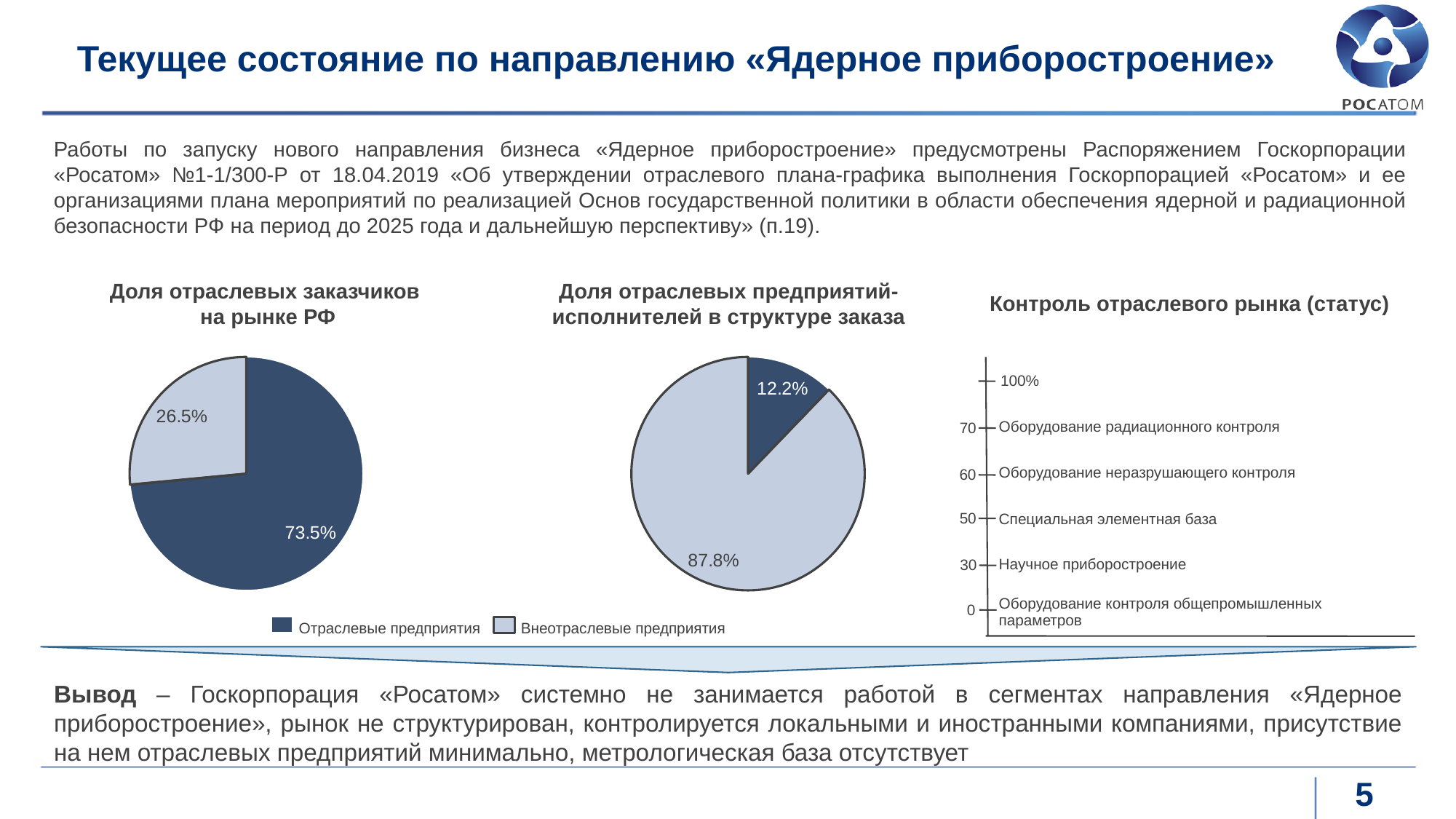
In the chart 'Доля отраслевых предприятий-исполнителей в структуре заказа', which category has the smallest slice? Отраслевые предприятия In the chart 'Доля отраслевых заказчиков на рынке РФ', what share is shown for Внеотраслевые предприятия? 26.5% In the chart 'Доля отраслевых предприятий-исполнителей в структуре заказа', what share is shown for Внеотраслевые предприятия? 87.8% In the 'Контроль отраслевого рынка (статус)' scale, what value is marked next to 'Научное приборостроение'? 30 How many entries does the legend below the pie charts list? 2 What type of chart is 'Доля отраслевых заказчиков на рынке РФ'? Pie chart In the chart 'Доля отраслевых заказчиков на рынке РФ', which category has the largest slice? Отраслевые предприятия In the chart 'Доля отраслевых заказчиков на рынке РФ', what is the difference between the shares of Отраслевые предприятия and Внеотраслевые предприятия? 47% Which is larger: the share of Отраслевые предприятия in the left pie chart or the share of Отраслевые предприятия in the middle pie chart? The left pie chart (73.5%) In the chart 'Доля отраслевых предприятий-исполнителей в структуре заказа', what share is shown for Отраслевые предприятия? 12.2% In the chart 'Доля отраслевых заказчиков на рынке РФ', what share is shown for Отраслевые предприятия? 73.5% In the chart 'Доля отраслевых предприятий-исполнителей в структуре заказа', what is the difference between the shares of Внеотраслевые предприятия and Отраслевые предприятия? 75.6%